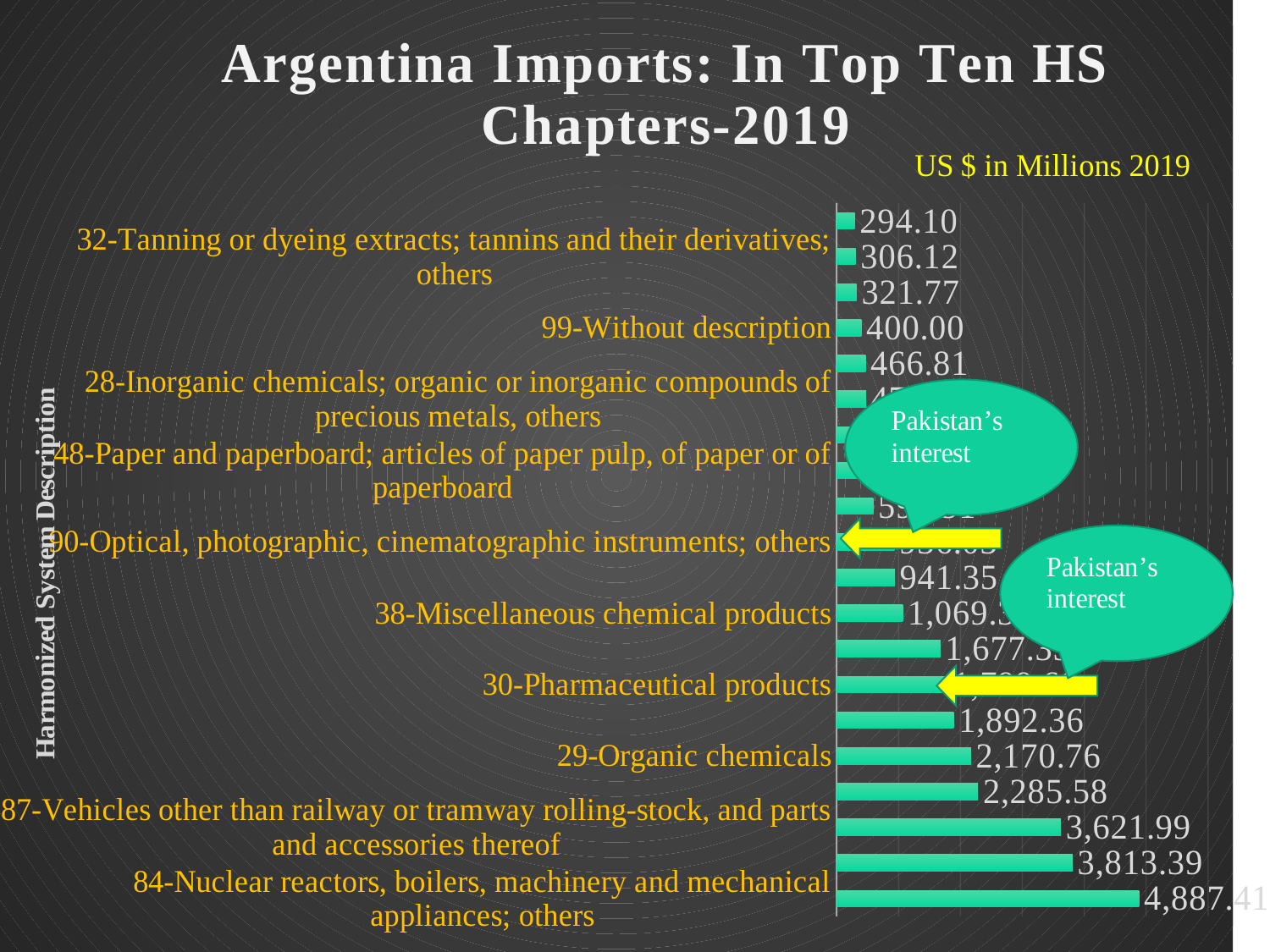
What is the import value for 87-Vehicles other than railway or tramway rolling-stock, and parts and accessories thereof? 3,621.99 What is the smallest value shown on the chart? 294.10 What is the import value for 99-Without description? 400.00 What is the import value for 29-Organic chemicals? 2,170.76 What is the import value for 84-Nuclear reactors, boilers, machinery and mechanical appliances; others? 4,887.41 Is the import value for 38-Miscellaneous chemical products greater or less than 1,000? greater Do the bar values increase or decrease going from the top of the chart to the bottom? increase What is the difference between the import values for 84-Nuclear reactors and 87-Vehicles? 1,265.42 Which has a larger import value: 87-Vehicles or 29-Organic chemicals? 87-Vehicles What type of chart is shown on the slide? bar chart In what units are the values on the chart expressed? US $ in Millions 2019 Which labelled HS chapter has the highest import value? 84-Nuclear reactors, boilers, machinery and mechanical appliances; others